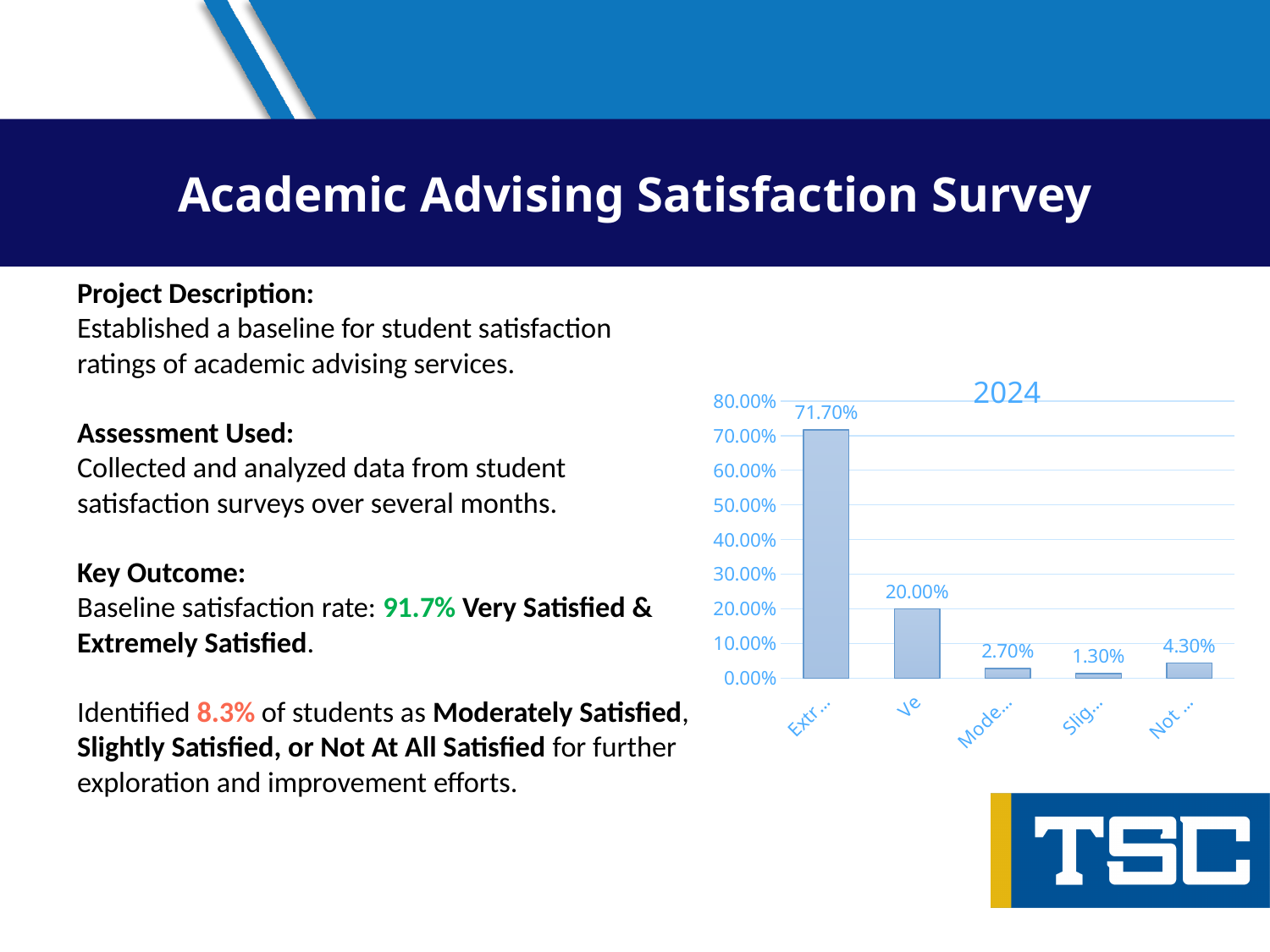
Which bar in the chart has the lowest value? the fourth bar ("Slig..."), 1.30% Which bar in the chart has the highest value? the first bar ("Extr..."), 71.70% What is the value of the second bar (labelled "Ve...") in the chart? 20.00% What is the difference between the first bar (71.70%) and the second bar (20.00%) in the chart? 51.70% What is the title of the chart on the slide? 2024 What is the value of the fourth bar (labelled "Slig...") in the chart? 1.30% Which is larger in the chart: the third bar ("Mode...") or the fifth bar ("Not ...")? the fifth bar ("Not ..."), 4.30% What kind of chart is shown on the slide? bar chart What is the value of the third bar (labelled "Mode...") in the chart? 2.70% What is the value of the first bar (labelled "Extr...") in the chart? 71.70% How many bars are plotted in the chart? 5 What is the value of the fifth bar (labelled "Not ...") in the chart? 4.30%